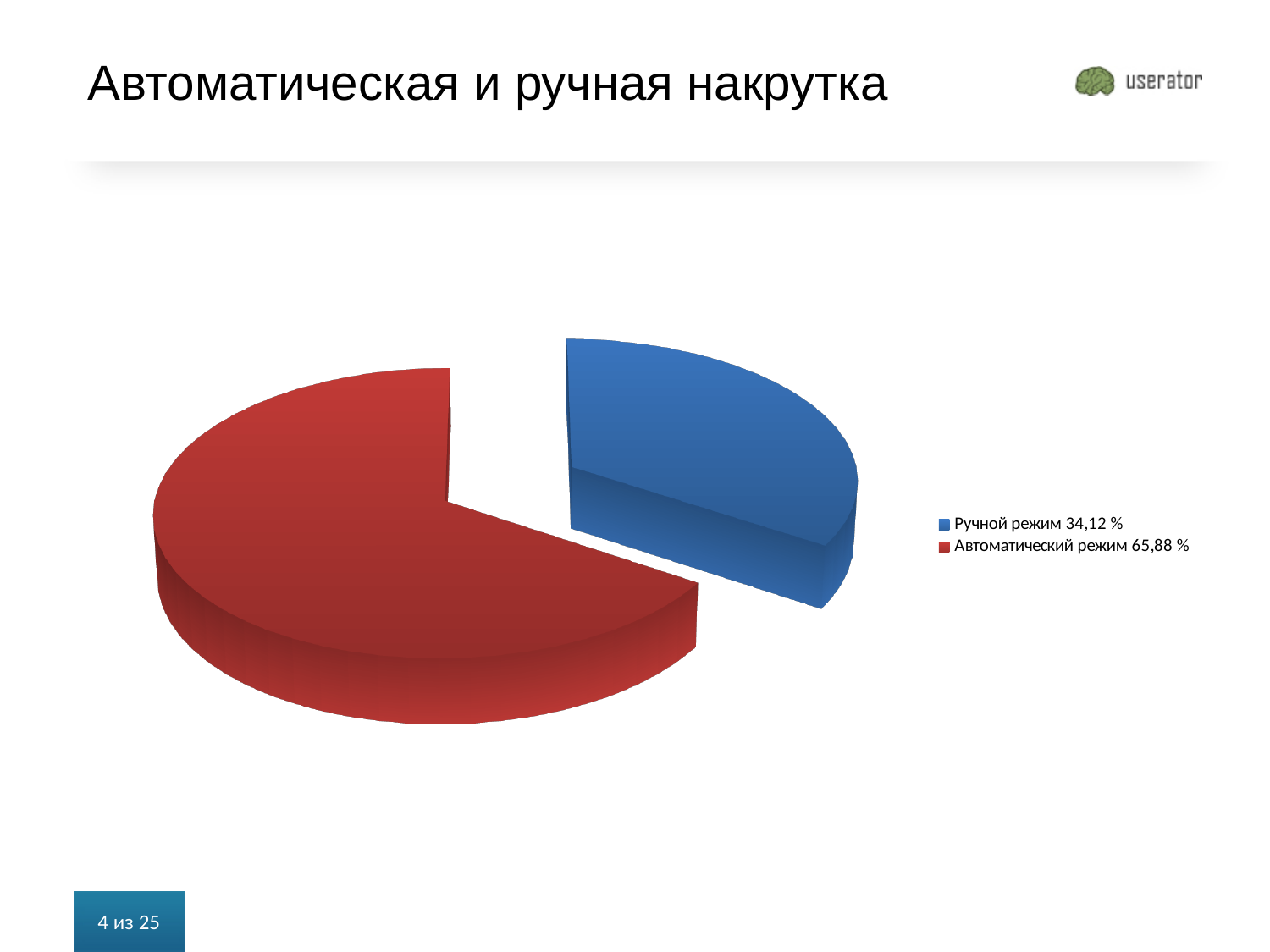
What kind of chart is shown on the slide? Pie chart What colour is the Автоматический режим slice? Red What share of the pie does Автоматический режим have? 65,88 % Which slice of the pie chart is the smallest? Ручной режим How many entries does the legend list? 2 What colour is the Ручной режим slice? Blue Which is larger, the share for Ручной режим or for Автоматический режим? Автоматический режим What share of the pie does Ручной режим have? 34,12 % How many slices does the pie chart have? 2 What is the difference in percentage points between the Автоматический режим and Ручной режим shares? 31,76 % Which slice of the pie chart is the largest? Автоматический режим